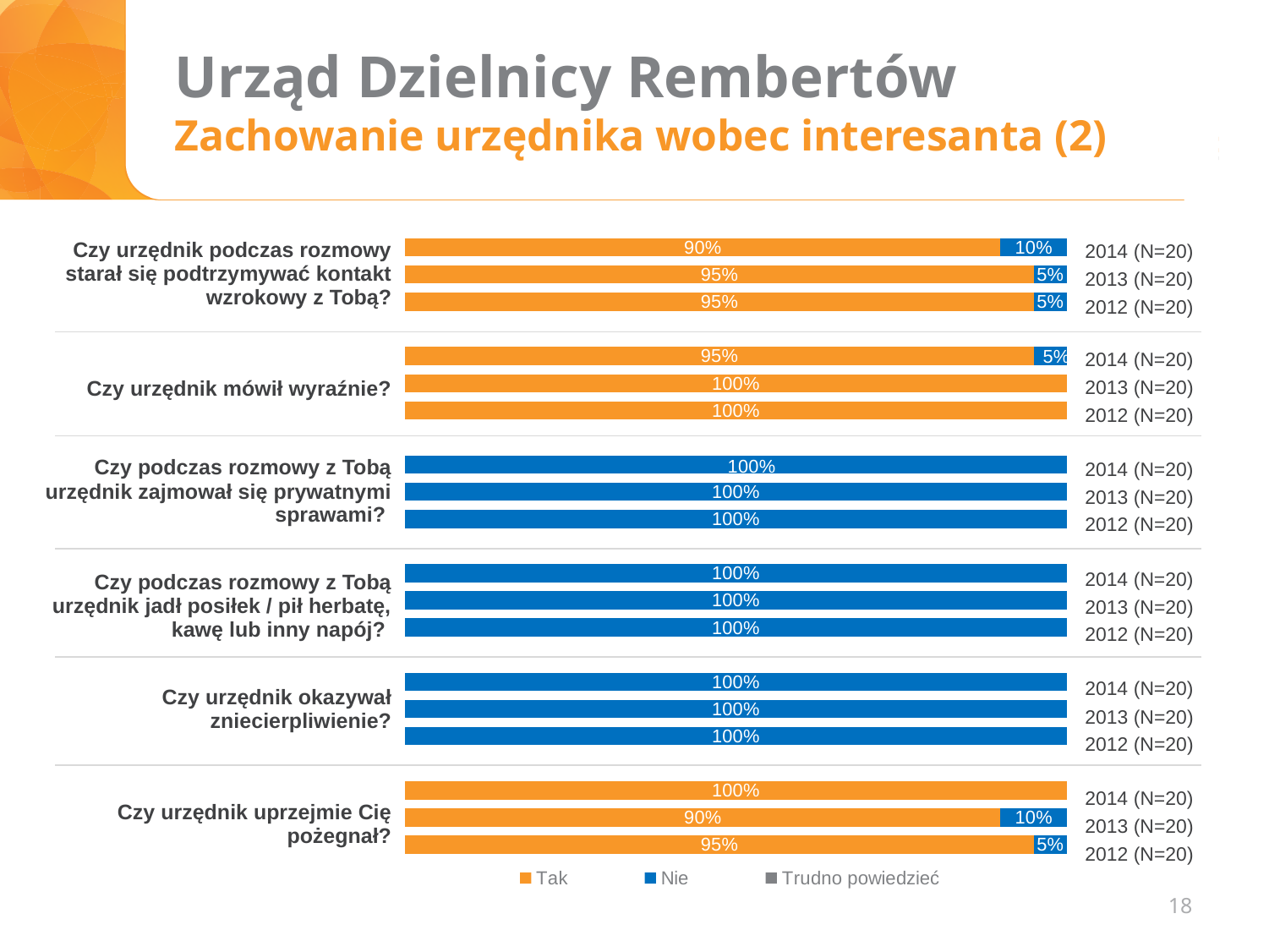
What is the 'Nie' value for 2012 for the question 'Czy urzędnik okazywał zniecierpliwienie?'? 100% For the question 'Czy urzędnik mówił wyraźnie?', is the 'Tak' value for 2014 larger or smaller than for 2013? smaller For the question 'Czy urzędnik uprzejmie Cię pożegnał?', which year has the lowest 'Tak' value? 2013 Which colour represents the 'Nie' series in the legend? blue For the question 'Czy urzędnik uprzejmie Cię pożegnał?', which year has the highest 'Tak' value? 2014 What is the 'Tak' value for 2014 for the question 'Czy urzędnik podczas rozmowy starał się podtrzymywać kontakt wzrokowy z Tobą?'? 90% What is the 'Tak' value for 2014 for the question 'Czy urzędnik mówił wyraźnie?'? 95% What kind of chart is shown on the slide? stacked bar chart What is the 'Nie' value for 2013 for the question 'Czy urzędnik uprzejmie Cię pożegnał?'? 10% What is the total of the stacked bar for 2013 for the question 'Czy urzędnik uprzejmie Cię pożegnał?'? 100% How many series does the legend list? 3 For the question 'Czy urzędnik podczas rozmowy starał się podtrzymywać kontakt wzrokowy z Tobą?', what is the difference between the 'Tak' values for 2013 and 2014? 5%